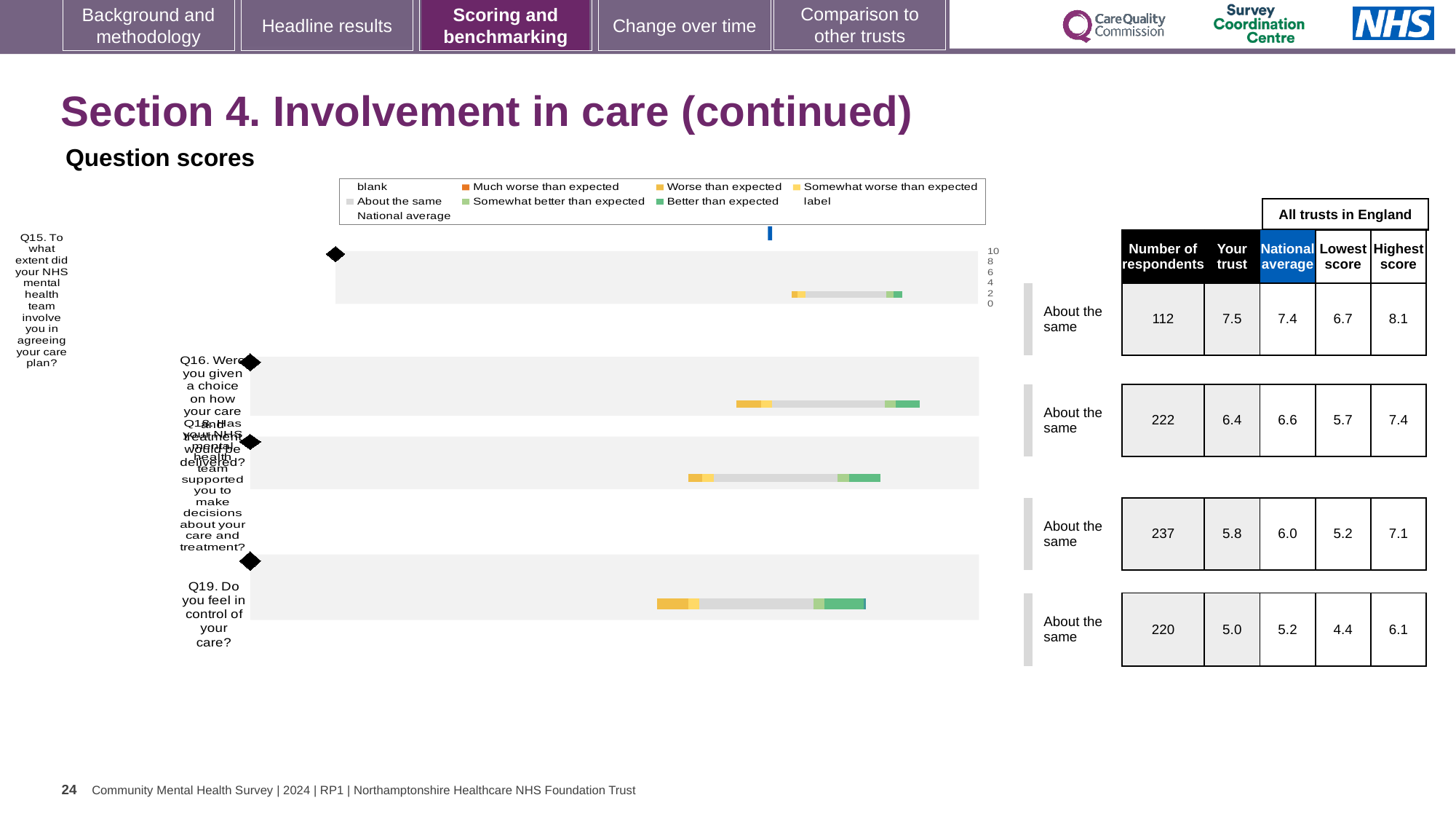
What is the highest score among all trusts in England for Q16 (choice on how care and treatment would be delivered)? 7.4 For Q16, which is larger: the 'Your trust' score or the national average? National average Which question has the highest 'Your trust' score? Q15 What benchmark category is shown next to each of the four questions in the chart? About the same What is the difference between the highest score (8.1) and the lowest score (6.7) for Q15? 1.4 Which question has the lowest 'Your trust' score? Q19 What is the 'Your trust' score for Q15 (involvement in agreeing your care plan)? 7.5 What is the national average score for Q19 (feeling in control of your care)? 5.2 Do the 'Your trust' scores rise or fall going down the chart from Q15 to Q19? fall What kind of chart is used to show the question scores on this slide? bar chart How many respondents answered Q18 (supported to make decisions about care and treatment)? 237 How many questions (categories) are plotted in the question scores chart? 4